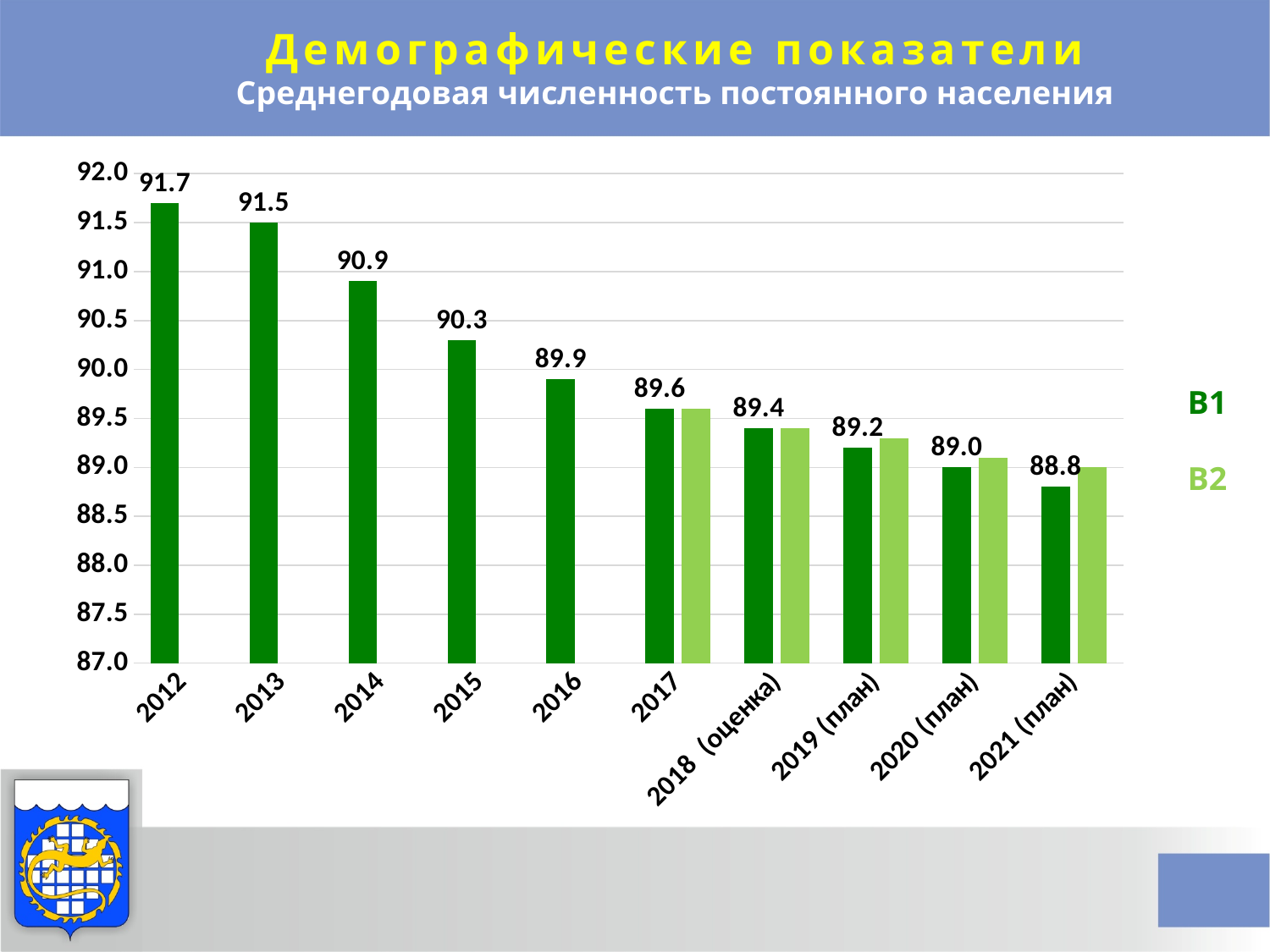
Which category has the lowest В1 value? 2021 (план) Which is larger, the В1 value for 2014 or for 2016? 2014 What is the В1 value for 2021 (план)? 88.8 Is the В2 value for 2019 (план) greater or less than 89.0? greater Which year has the highest В1 value? 2012 What is the В1 value for 2012? 91.7 What is the difference between the В1 values for 2012 and 2021 (план)? 2.9 How many series does the legend list? 2 Do the В1 values rise or fall from 2012 to 2021 (план)? fall What is the В1 value for 2015? 90.3 What kind of chart is shown on the slide? bar chart How many categories are shown on the x axis? 10